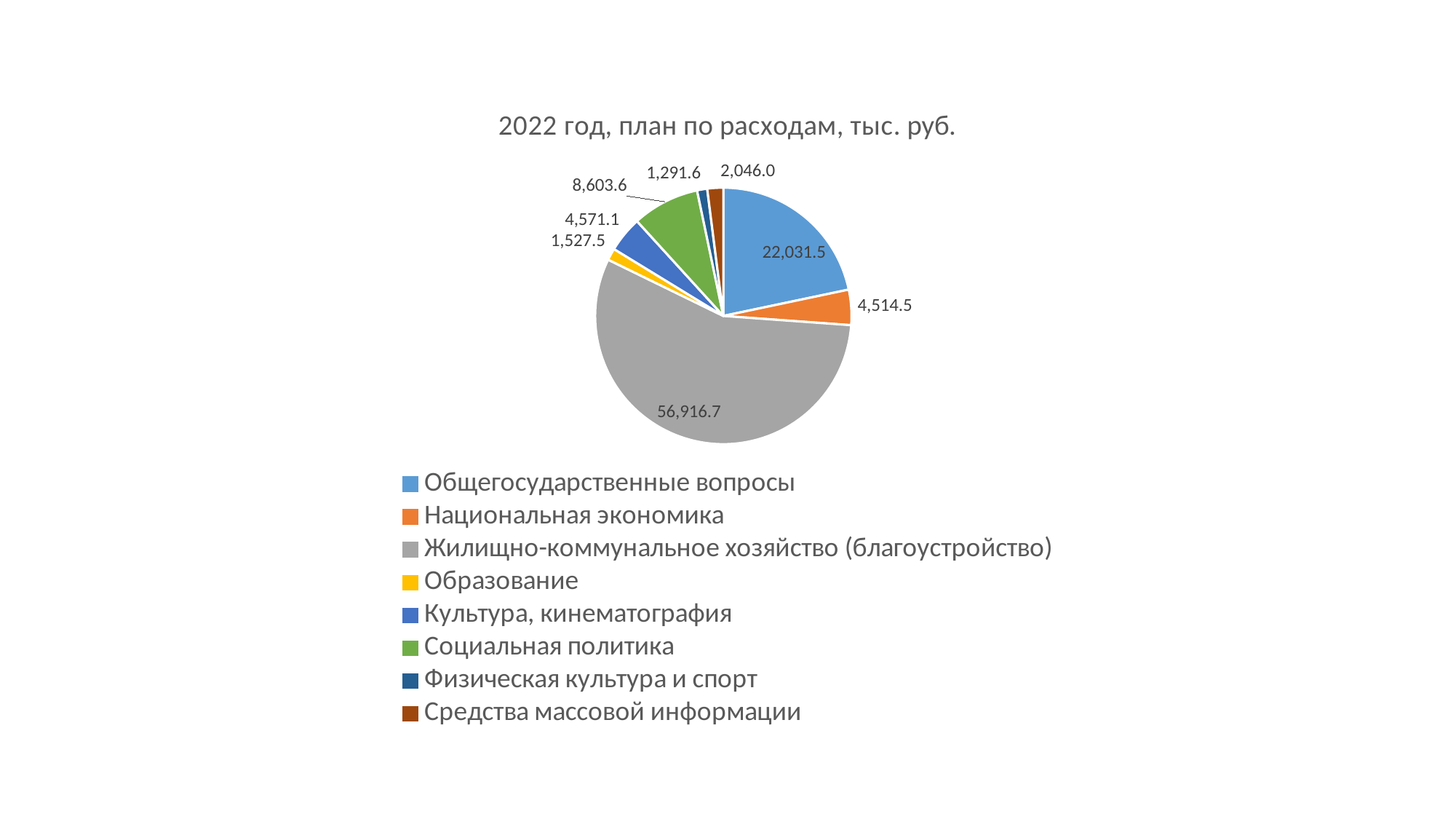
How many categories does the legend list? 8 What is the value for Социальная политика? 8,603.6 What is the title of the chart? 2022 год, план по расходам, тыс. руб. What is the value for Средства массовой информации? 2,046.0 What is the value for Общегосударственные вопросы? 22,031.5 What is the value for Жилищно-коммунальное хозяйство (благоустройство)? 56,916.7 What colour is the slice for Образование? Yellow Which category has the smallest slice? Физическая культура и спорт What type of chart is shown on the slide? Pie chart Which is larger, Социальная политика or Культура, кинематография? Социальная политика What is the difference between Общегосударственные вопросы and Национальная экономика? 17,517.0 Which category has the largest slice? Жилищно-коммунальное хозяйство (благоустройство)